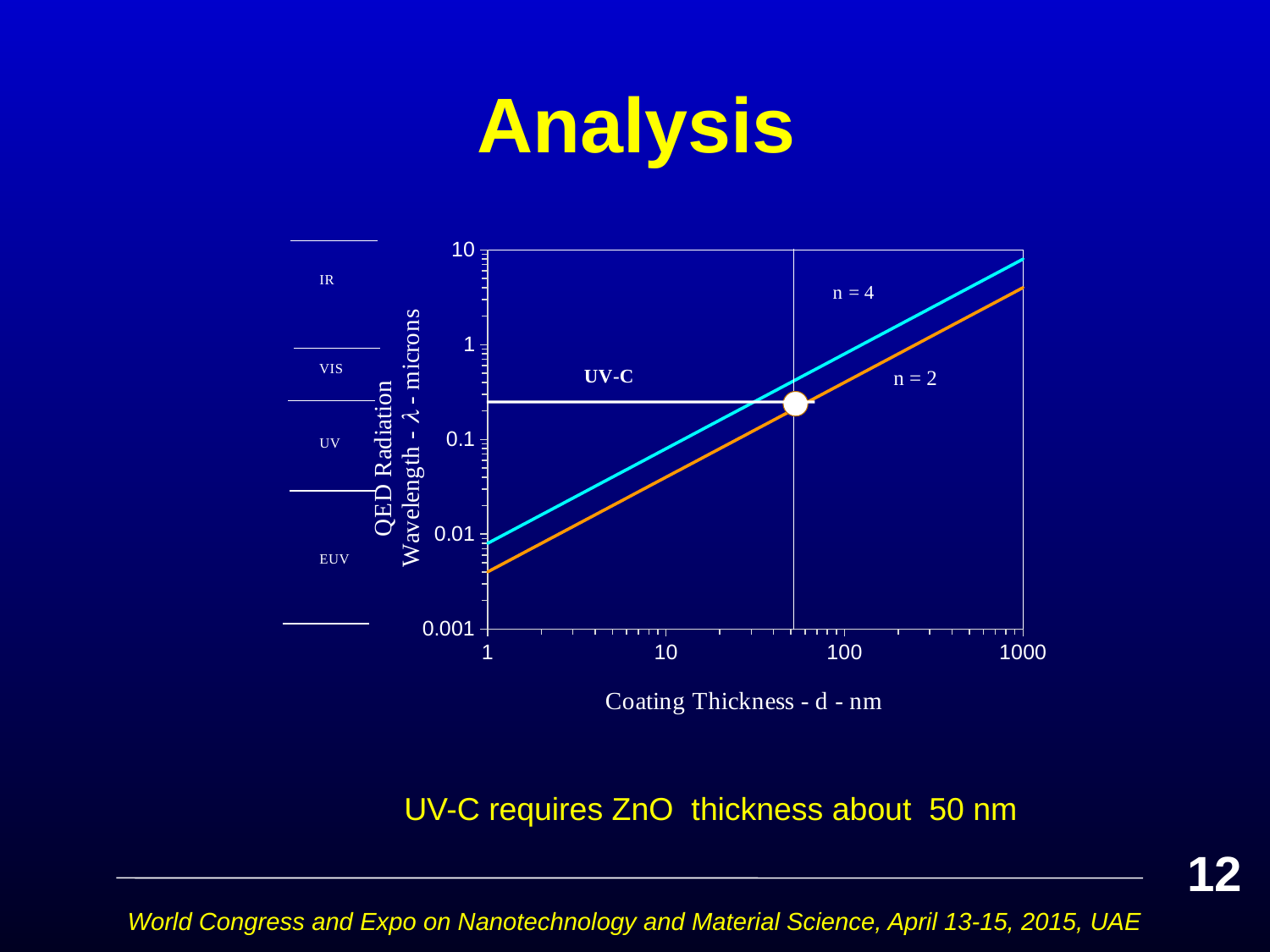
How many plotted lines (series) are labelled on the chart? 2 What is the x-axis label of the chart? Coating Thickness - d - nm What kind of chart is shown on the slide? line chart At a coating thickness of 1000 nm, is the wavelength for the n = 2 line greater or less than 1 micron? greater At a coating thickness of 1000 nm, is the wavelength for the n = 4 line greater or less than 1 micron? greater At a coating thickness of 1 nm, is the wavelength for the n = 2 line greater or less than 0.01 microns? less Do the plotted lines rise or fall as coating thickness increases? rise What is the minimum value shown on the y axis of the chart? 0.001 Which line lies higher on the chart, n = 4 or n = 2? n = 4 What is the maximum value shown on the x axis of the chart? 1000 What are the labels of the two plotted lines on the chart? n = 4 and n = 2